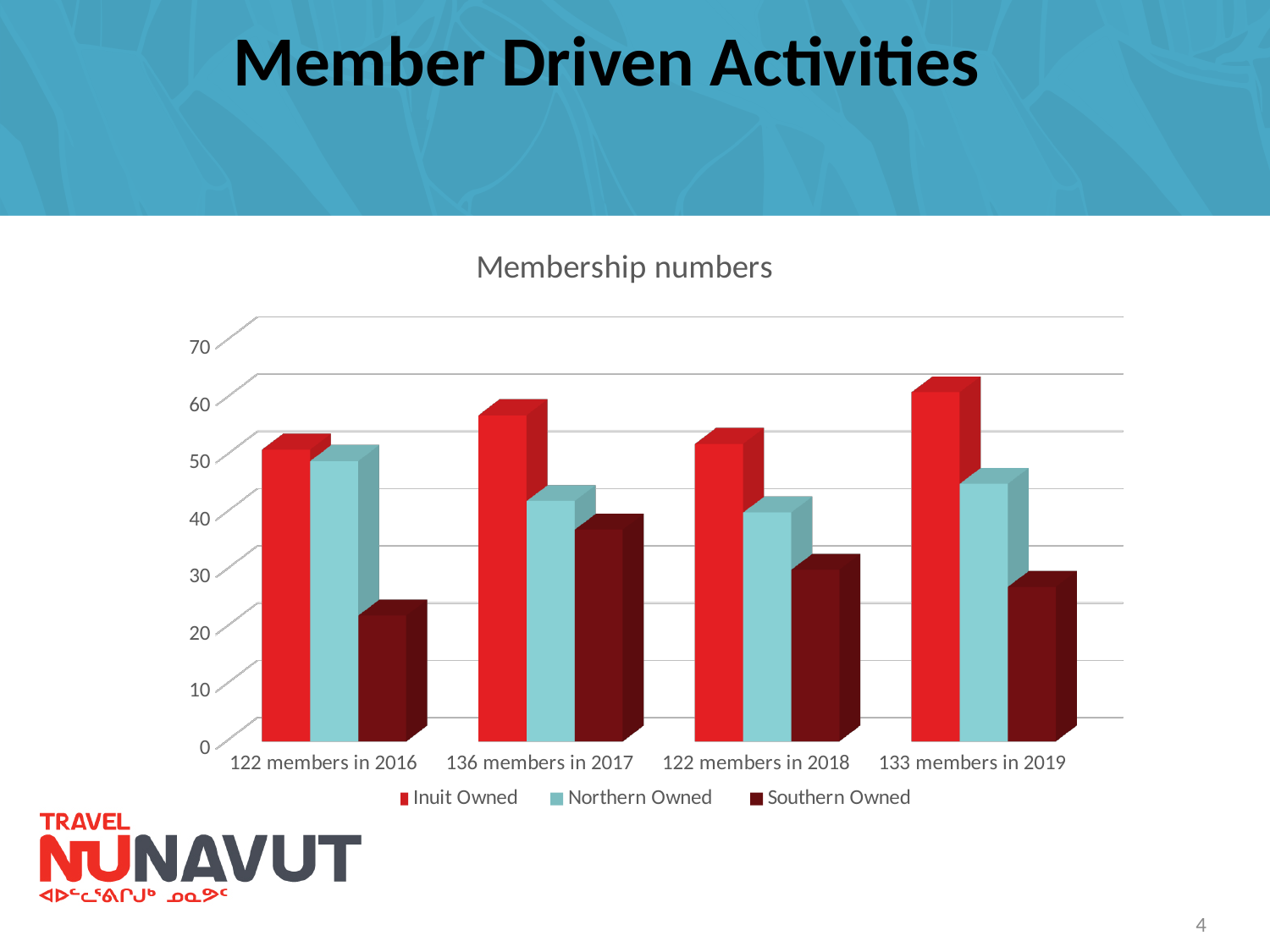
Is the Southern Owned value for '122 members in 2016' greater or less than 30? less Which series has the highest value in the '136 members in 2017' category? Inuit Owned Is the Inuit Owned value for '133 members in 2019' greater or less than 50? greater Which is larger for Northern Owned: the value for '122 members in 2016' or the value for '122 members in 2018'? 122 members in 2016 How many categories are shown on the x axis? 4 Which category has the lowest Southern Owned value? 122 members in 2016 What kind of chart is shown on the slide? bar chart Which is larger in '122 members in 2016': the Inuit Owned value or the Southern Owned value? Inuit Owned What is the title of the chart? Membership numbers How many series does the legend list? 3 Is the Northern Owned value for '136 members in 2017' greater or less than 50? less Which category has the highest Inuit Owned value? 133 members in 2019